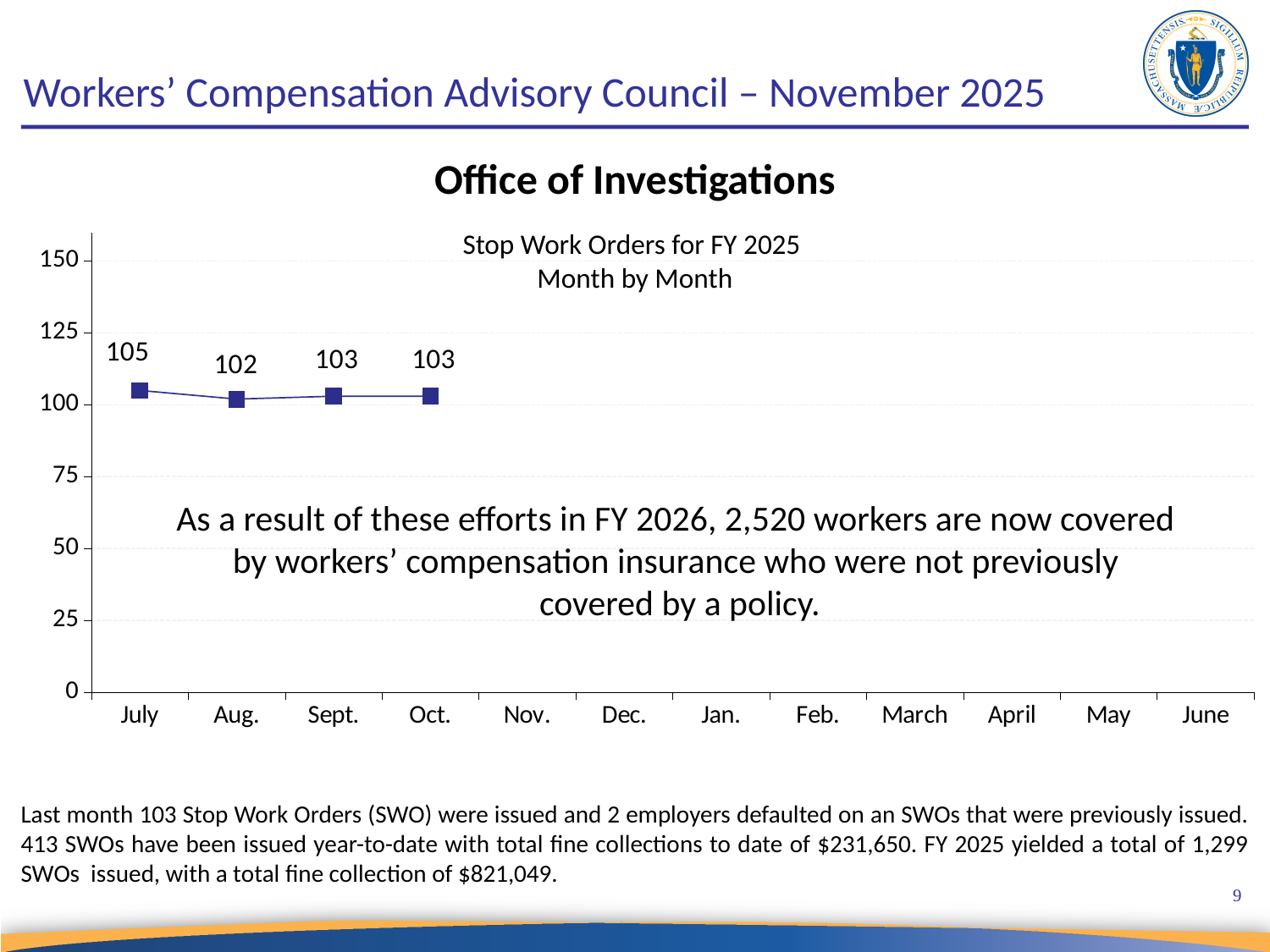
How many months have a plotted data point? 4 Which month has the highest plotted value? July What is the value for Oct.? 103 Which is larger, the value for July or the value for Oct.? July What is the title of the chart? Stop Work Orders for FY 2025 Month by Month What is the value for Sept.? 103 What is the difference between the values for July and Aug.? 3 Is the value for Aug. greater or less than 100? greater What is the value for Aug.? 102 What is the value for July? 105 Which month has the lowest plotted value? Aug. What kind of chart is shown? line chart